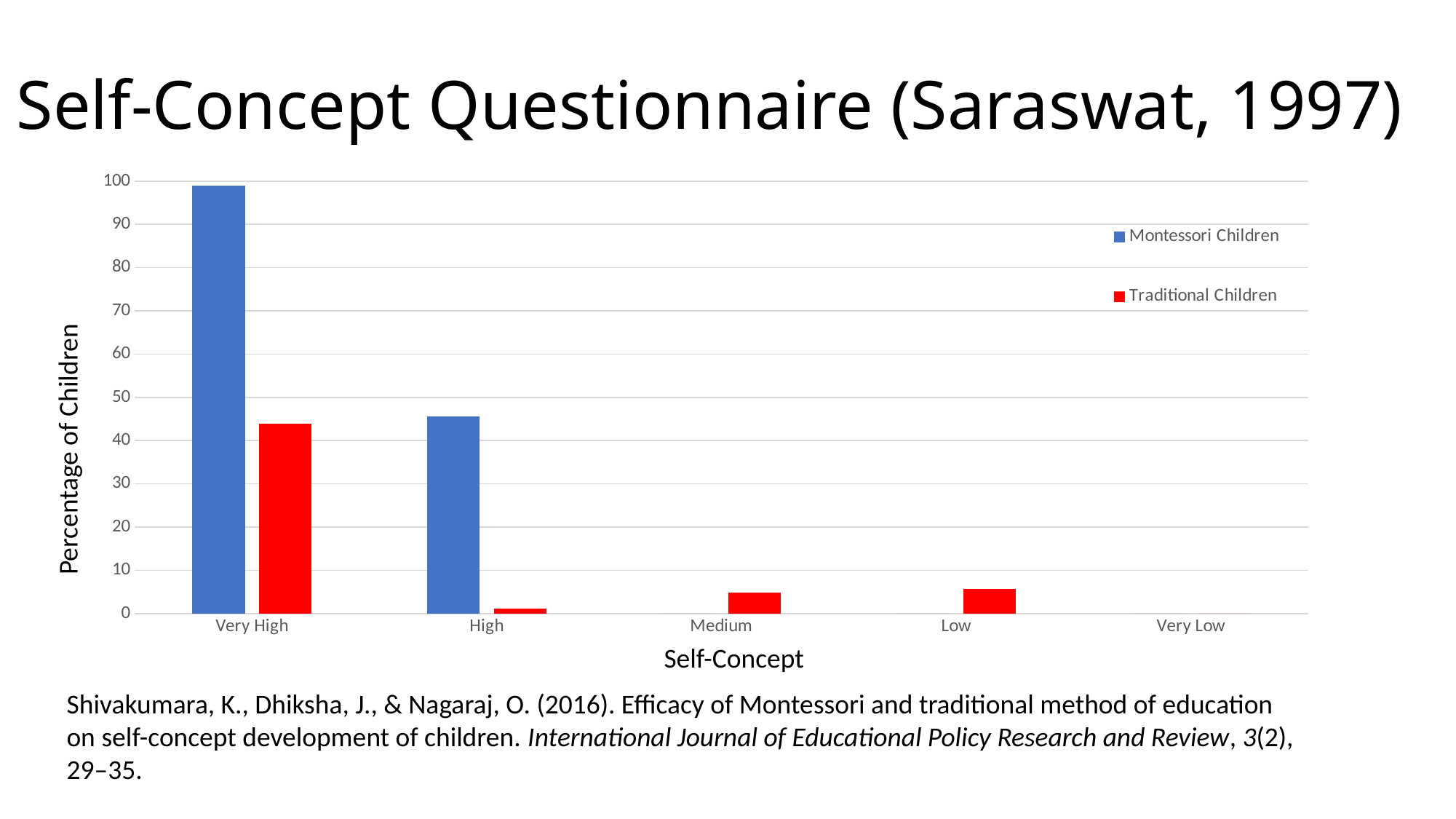
Which colour represents Traditional Children in the chart? red What is the label of the y axis? Percentage of Children Is the value for Traditional Children in the Very High category greater or less than 50? less Is the value for Montessori Children in the Very High category greater or less than 90? greater How many self-concept categories are shown on the x axis? 5 Is the value for Montessori Children in the High category greater or less than 40? greater In the Very High category, which series has the larger value, Montessori Children or Traditional Children? Montessori Children What kind of chart is shown on the slide? bar chart Which self-concept category has the highest value for Montessori Children? Very High How many series does the legend list? 2 Which self-concept category has the highest value for Traditional Children? Very High